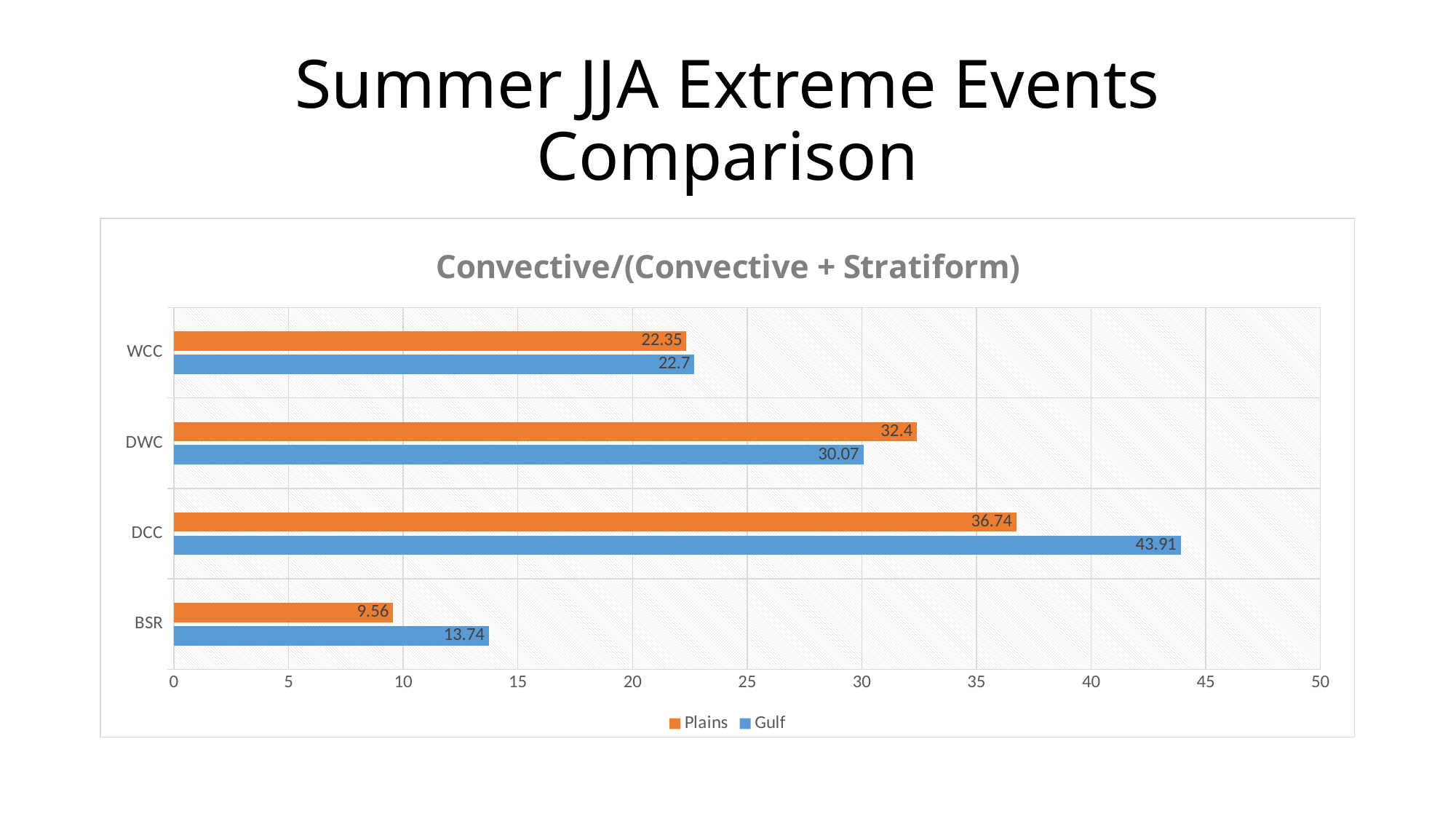
What is the Plains value for WCC? 22.35 What is the Gulf value for BSR? 13.74 What is the Plains value for DCC? 36.74 For DWC, which series has the larger value, Plains or Gulf? Plains What is the Gulf value for DWC? 30.07 What kind of chart is shown? Bar chart How many series does the legend list? 2 What is the difference between the Gulf and Plains values for DCC? 7.17 Which category has the lowest Plains value? BSR Which category has the highest Gulf value? DCC How many categories are shown on the chart? 4 What is the title of the chart? Convective/(Convective + Stratiform)